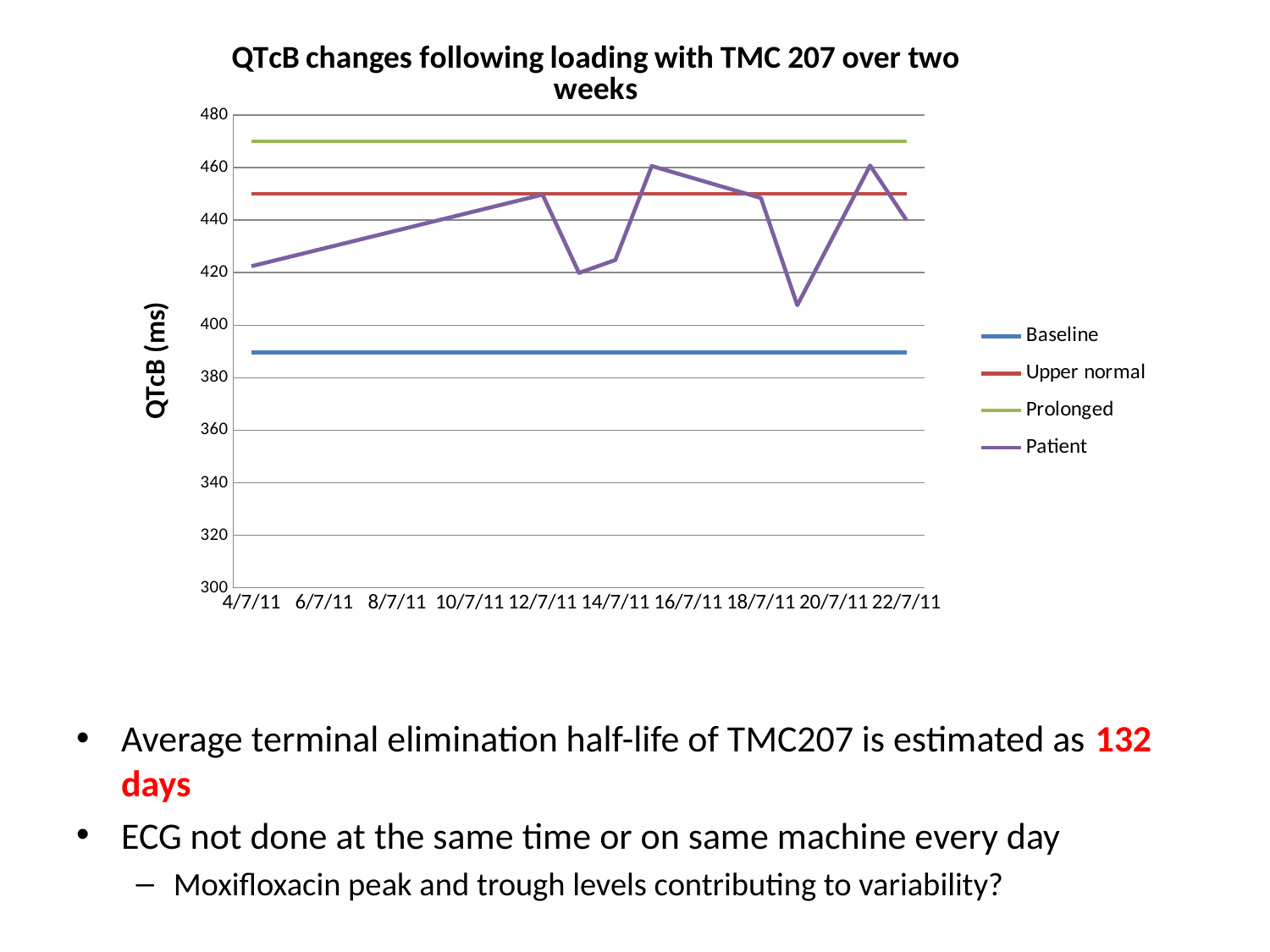
What kind of chart is shown on the slide? line chart How many series does the legend list? 4 Is the value of the Baseline line greater or less than 400? less What is the label on the vertical axis of the chart? QTcB (ms) Which of the flat reference lines is the lowest: Baseline, Upper normal or Prolonged? Baseline Does the Patient line rise or fall between 4/7/11 and 12/7/11? rise Is the value of the Upper normal line greater or less than 440? greater Is the Patient value at 14/7/11 greater or less than 440? less What is the title of the chart? QTcB changes following loading with TMC 207 over two weeks